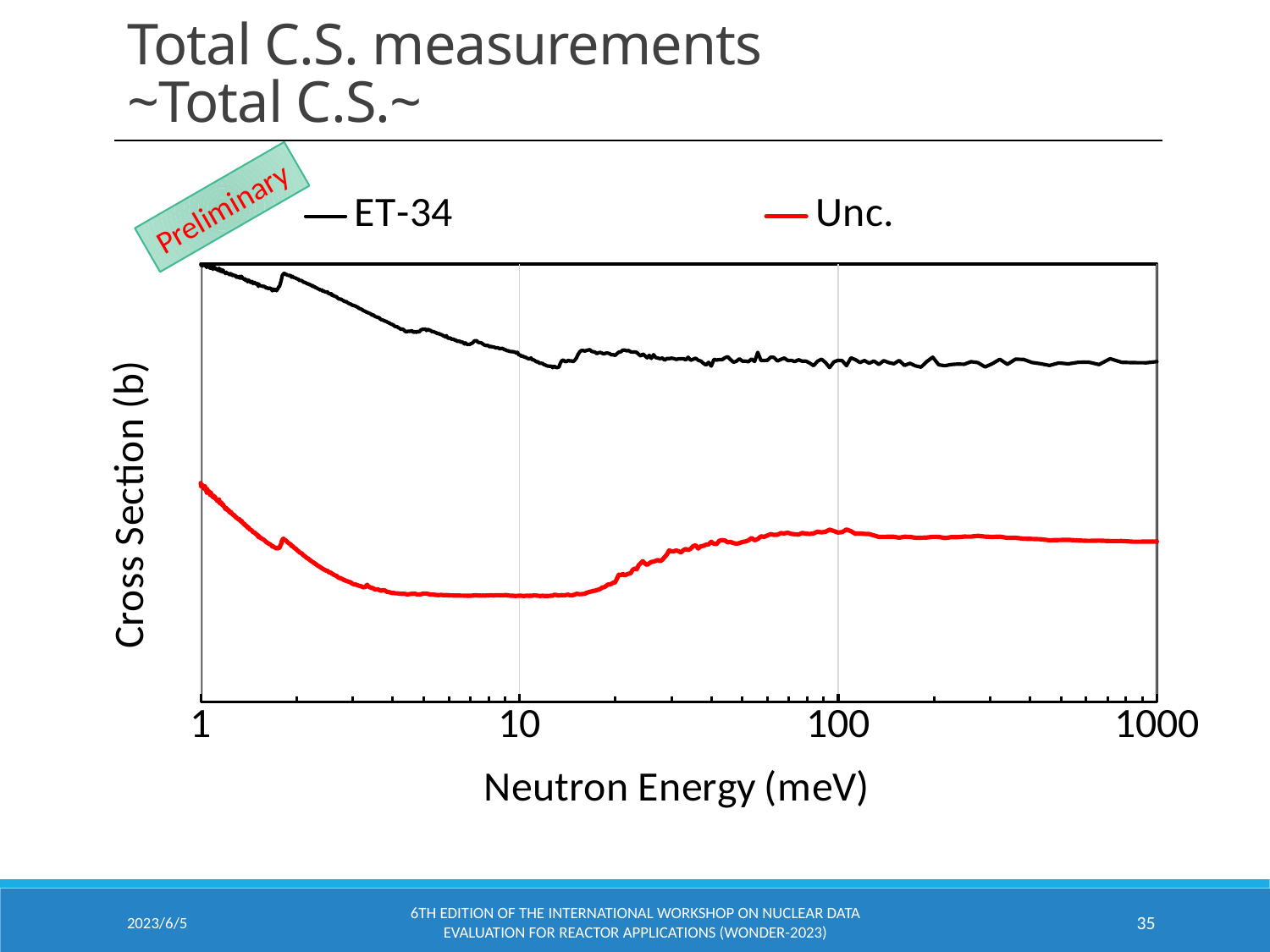
What kind of chart is shown on the slide? line chart What is the lowest neutron energy value labelled on the x axis? 1 What colour is the line for the ET-34 series? black What is the highest neutron energy value labelled on the x axis? 1000 Does the ET-34 line rise or fall as neutron energy increases from 1 meV to 10 meV? fall How many tick labels are printed on the x axis of the chart? 4 Does the Unc. line rise or fall as neutron energy increases from 10 meV to 100 meV? rise Which series is plotted higher on the chart across the whole energy range, ET-34 or Unc.? ET-34 How many series does the chart's legend list? 2 What are the two series named in the chart's legend? ET-34 and Unc. What is the title of the y axis of the chart? Cross Section (b) What is the title of the x axis of the chart? Neutron Energy (meV)